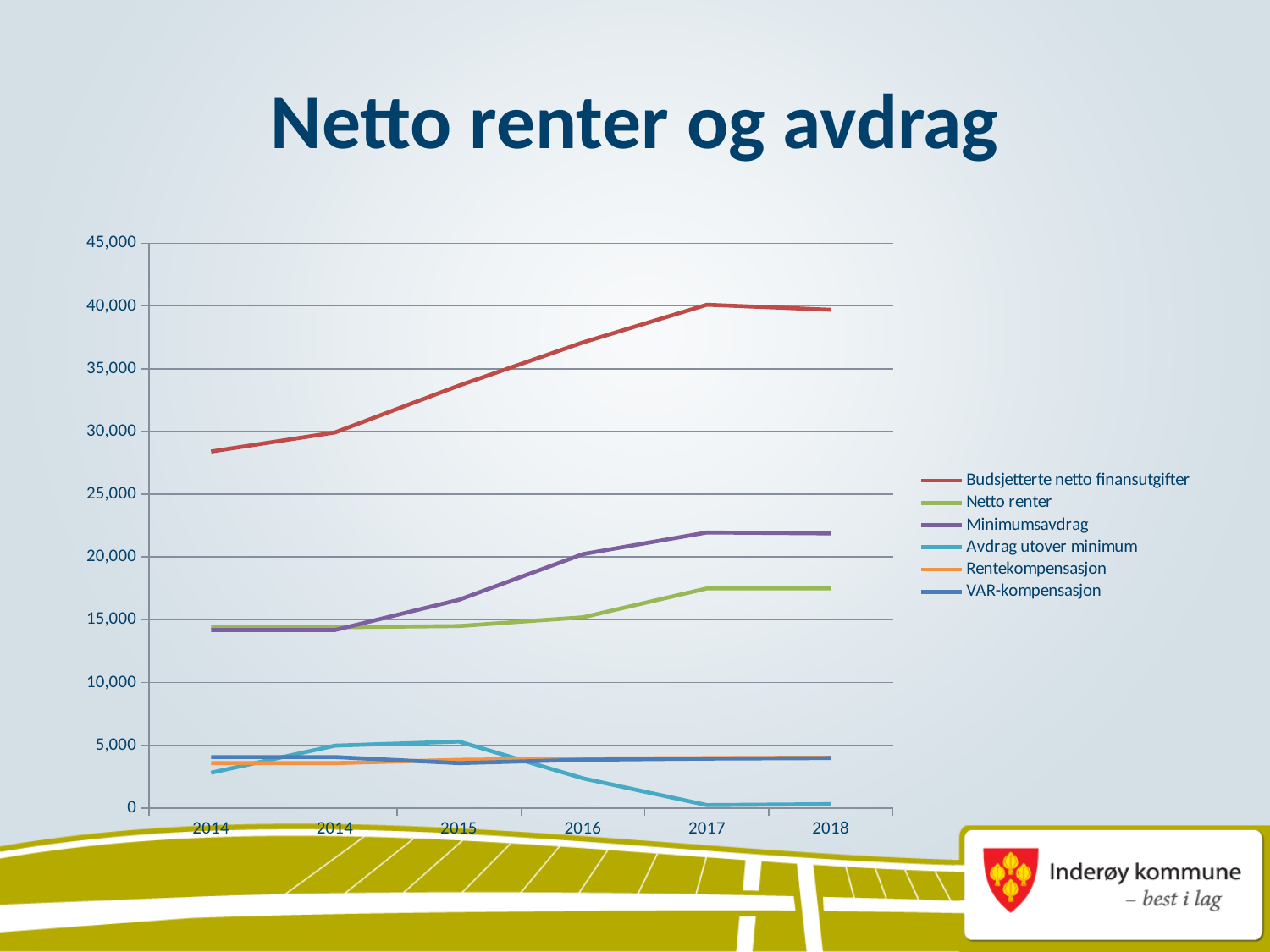
Which series has the highest values across the whole chart? Budsjetterte netto finansutgifter How many series does the legend list? 6 Does Budsjetterte netto finansutgifter rise or fall from the first 2014 point to 2017? Rise Does Avdrag utover minimum rise or fall from 2015 to 2017? Fall What kind of chart is shown on the slide? Line chart Is the value for Netto renter in 2018 greater or less than 20,000? less In 2017, which is larger: Minimumsavdrag or Netto renter? Minimumsavdrag Is the value for Budsjetterte netto finansutgifter in 2017 greater or less than 35,000? greater Which series has the lowest value in 2018? Avdrag utover minimum Is the value for Avdrag utover minimum in 2017 greater or less than 5,000? less How many points are plotted along the x axis for each series? 6